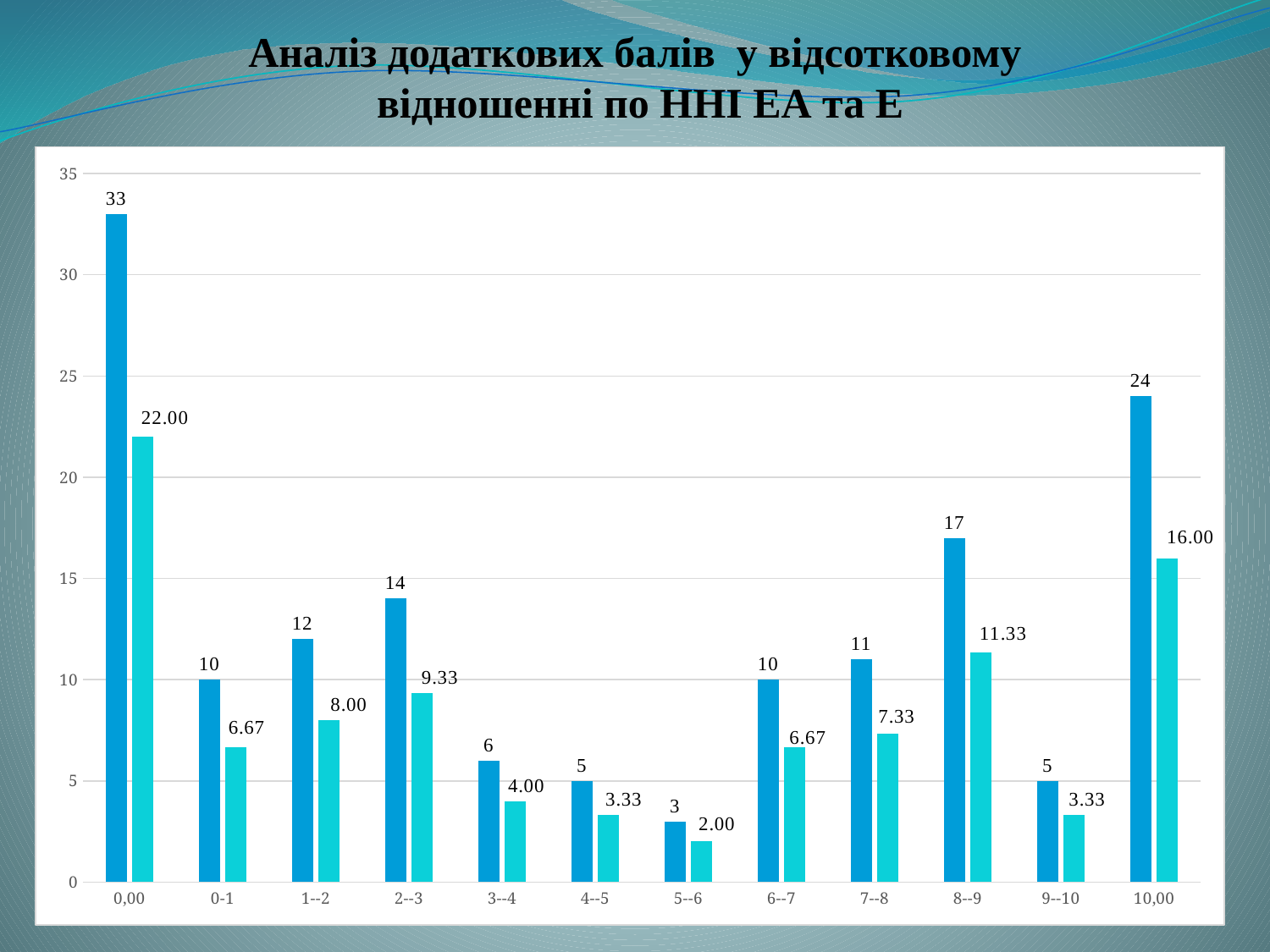
What is the difference between the dark blue bars for categories 10,00 and 8--9? 7 Which category has the highest dark blue bar? 0,00 Which category has the lowest light cyan bar? 5--6 What is the value of the light cyan bar for category 8--9? 11.33 What is the value of the dark blue bar for category 0,00? 33 What is the difference between the dark blue bar and the light cyan bar for category 0,00? 11 Do the dark blue bars rise or fall from category 3--4 to category 5--6? fall What kind of chart is shown on the slide? bar chart Which is larger: the dark blue bar for 2--3 or the dark blue bar for 1--2? 2--3 What is the value of the light cyan bar for category 10,00? 16.00 How many categories are shown on the x axis? 12 What is the value of the dark blue bar for category 5--6? 3